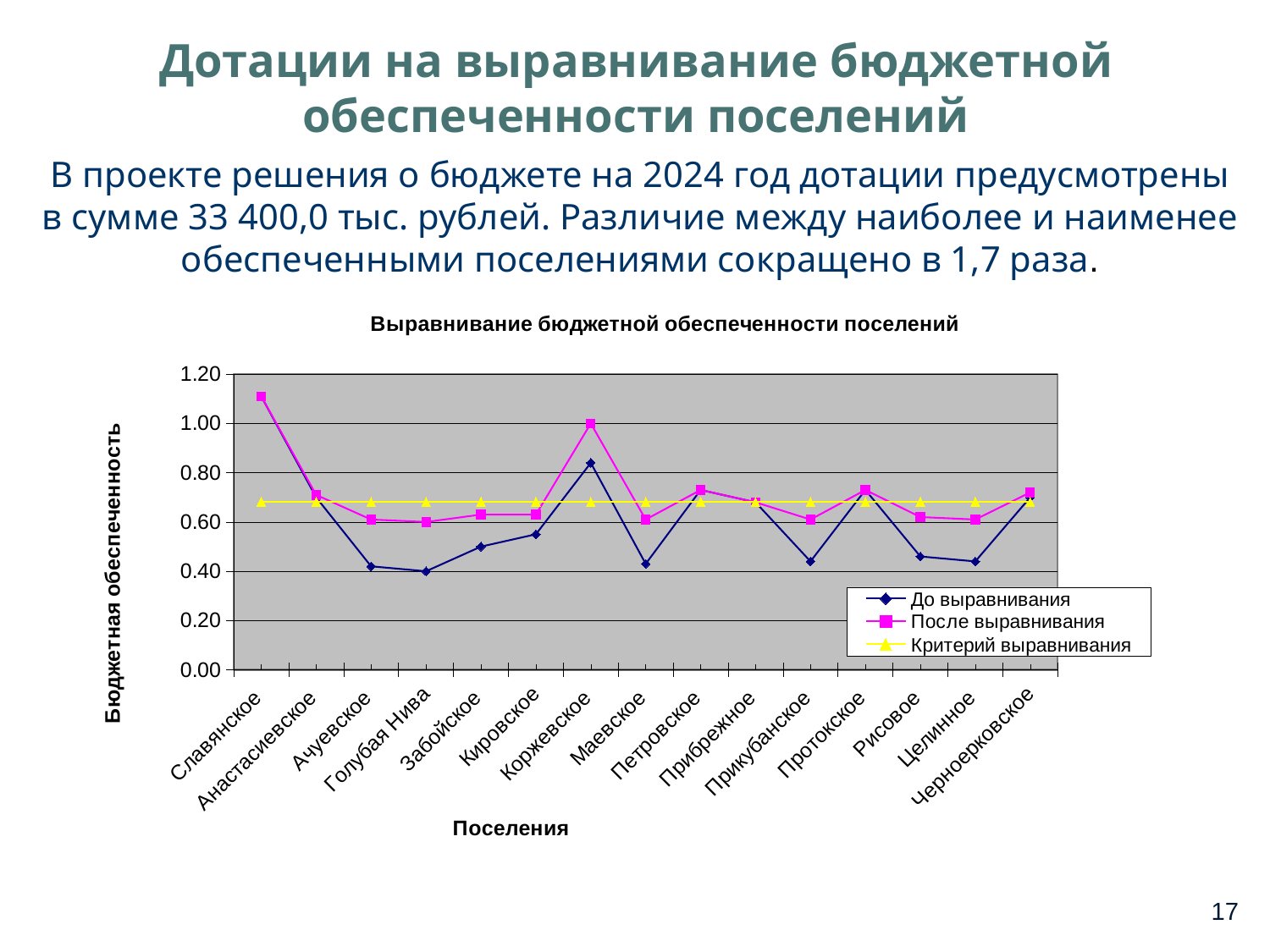
What kind of chart is shown on the slide? line chart Which settlement has the highest value for the series 'После выравнивания'? Славянское Is the value for Голубая Нива in the series 'После выравнивания' greater or less than 0.80? less Is the value for Славянское in the series 'До выравнивания' greater or less than 1.00? greater Which is larger in the series 'До выравнивания': the value for Славянское or the value for Коржевское? Славянское Is the value for Коржевское in the series 'До выравнивания' greater or less than 0.80? greater Which settlement has the highest value for the series 'До выравнивания'? Славянское How many settlements (categories) are plotted along the x axis? 15 What is the title of the chart? Выравнивание бюджетной обеспеченности поселений Which is larger in the series 'После выравнивания': the value for Коржевское or the value for Маевское? Коржевское How many series does the chart legend list? 3